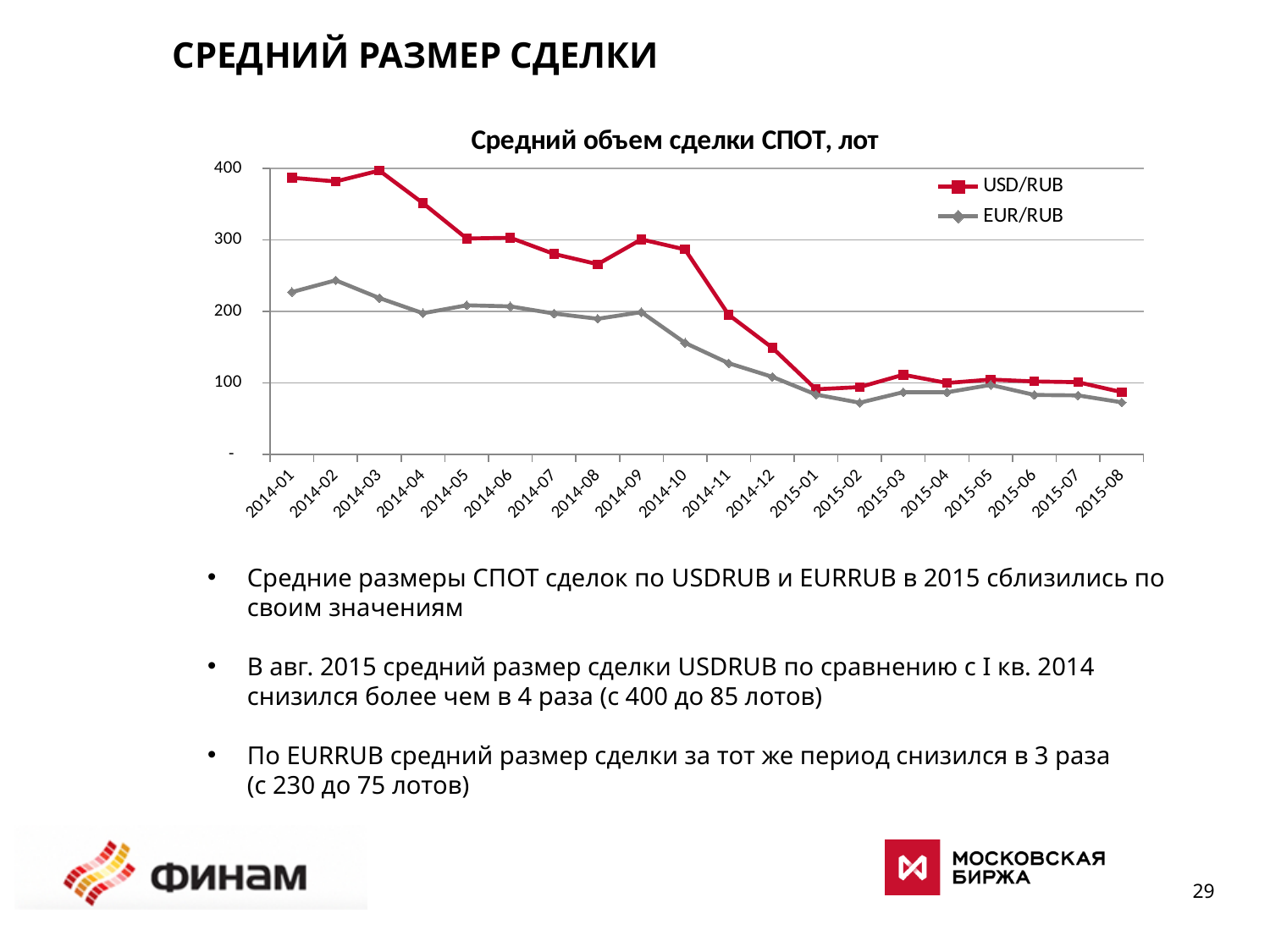
Do the USD/RUB values generally rise or fall from 2014-01 to 2015-08? fall Which series has the larger value in 2014-10, USD/RUB or EUR/RUB? USD/RUB How many series does the legend list? 2 What kind of chart is shown on the slide? line chart Is the EUR/RUB value for 2015-02 greater or less than 100? less Is the USD/RUB value for 2014-01 greater or less than 300? greater What is the title of the chart? Средний объем сделки СПОТ, лот Is the EUR/RUB value for 2014-01 greater or less than 200? greater How many months are plotted along the x axis? 20 Which series is drawn in red? USD/RUB In which month does the EUR/RUB series reach its highest value? 2014-02